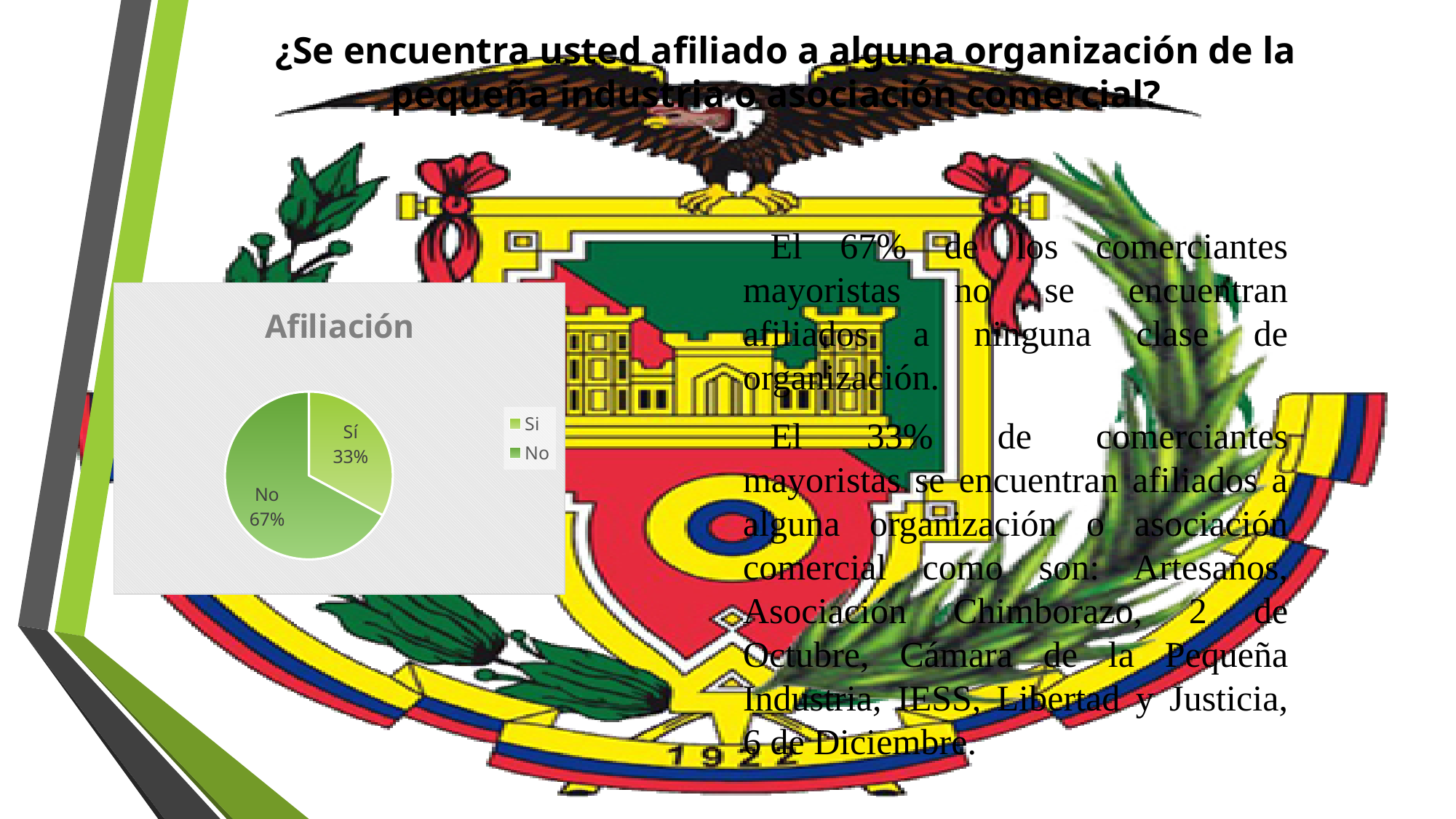
How many entries does the legend list? 2 Which slice is the largest in the pie chart? No Which is larger, the 'Sí' slice or the 'No' slice? No Which slice is the smallest in the pie chart? Sí What kind of chart is shown on the slide? pie chart How many slices does the pie chart have? 2 What is the difference in percentage points between the 'No' and 'Sí' slices? 34 What is the title of the chart? Afiliación What share of the pie does the 'Sí' slice take? 33% What percentage does the 'No' slice represent? 67% What percentage does the 'Sí' slice represent? 33%